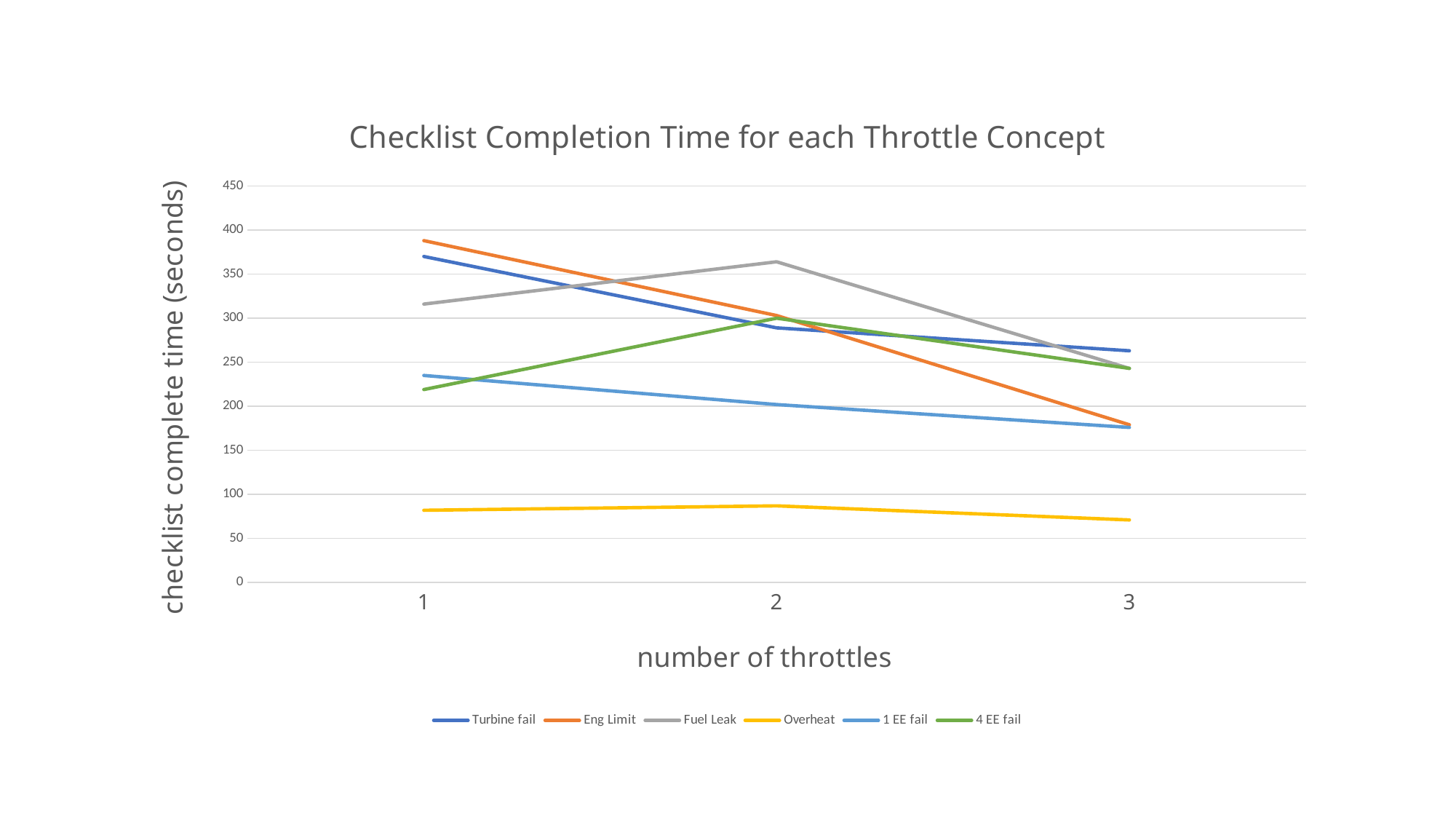
Which series has the highest checklist completion time at 2 throttles? Fuel Leak How many series does the legend list? 6 Is the value for Eng Limit at 1 throttle greater or less than 350? greater Is the value for Fuel Leak at 2 throttles greater or less than 350? greater Does the Eng Limit line rise or fall as the number of throttles increases from 1 to 3? fall Which series has the lowest checklist completion time at 3 throttles? Overheat What is the title of the chart? Checklist Completion Time for each Throttle Concept How many points along the x axis (number of throttles) are plotted for each series? 3 Is the value for 1 EE fail at 3 throttles greater or less than 200? less What kind of chart is shown on the slide? line chart At 3 throttles, which is higher: Turbine fail or 4 EE fail? Turbine fail